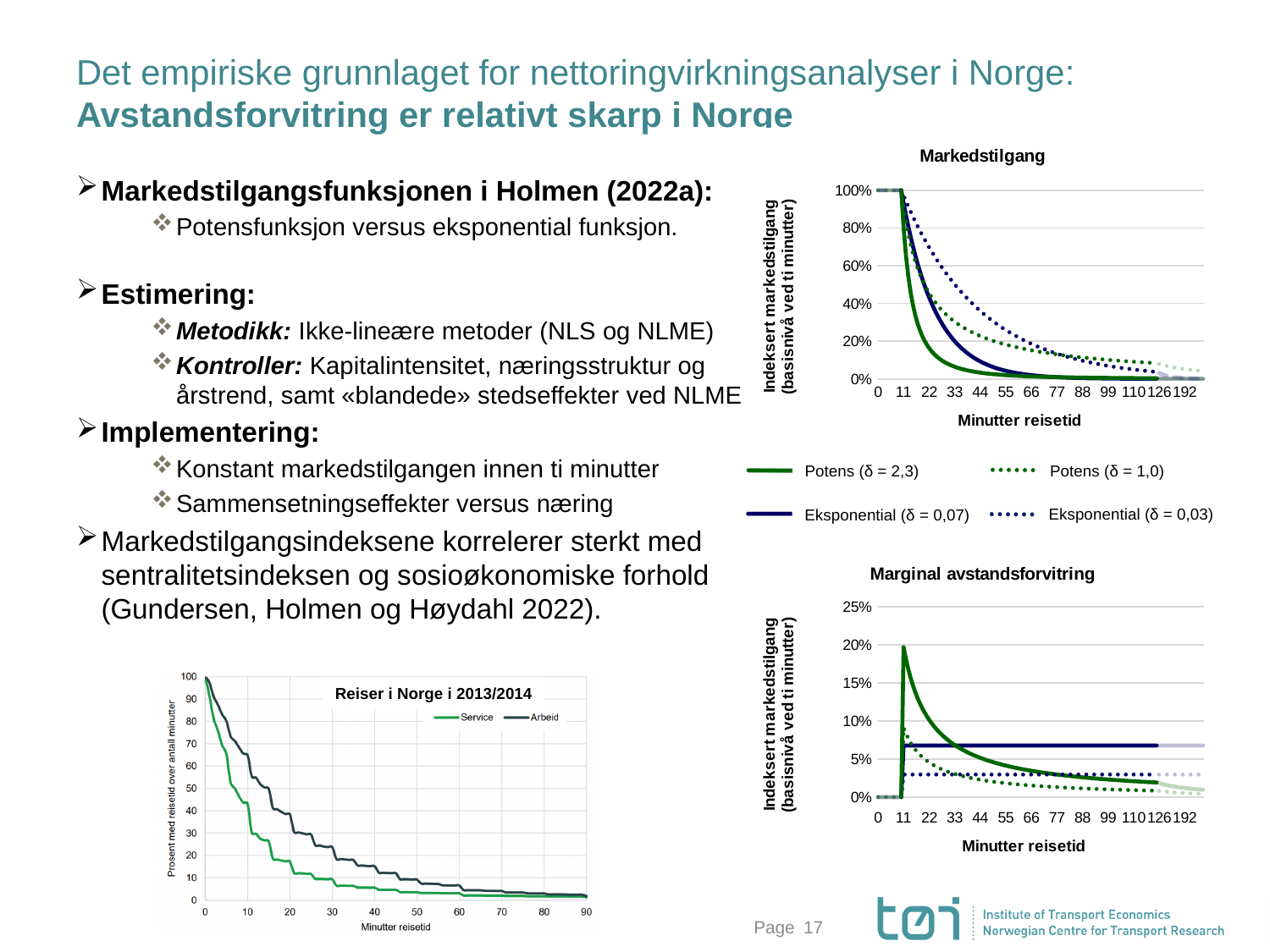
In the 'Markedstilgang' chart, is the value for Potens (δ = 2,3) at 33 minutes greater or less than 20%? less In the 'Marginal avstandsforvitring' chart, is the flat value for Eksponential (δ = 0,07) greater or less than 5%? greater In the 'Reiser i Norge i 2013/2014' chart, is the value for Arbeid at 60 minutes greater or less than 10? less How many series does the legend of the 'Markedstilgang' chart list? 4 In the 'Markedstilgang' chart, what is the label of the x axis? Minutter reisetid In the 'Reiser i Norge i 2013/2014' chart, which series has the larger value at 20 minutes, Service or Arbeid? Arbeid How many series does the legend of the 'Reiser i Norge i 2013/2014' chart list? 2 In the 'Marginal avstandsforvitring' chart, which series reaches the highest value? Potens (δ = 2,3) In the 'Markedstilgang' chart, do the values rise or fall as travel time increases? Fall What type of chart is the 'Markedstilgang' chart? Line chart